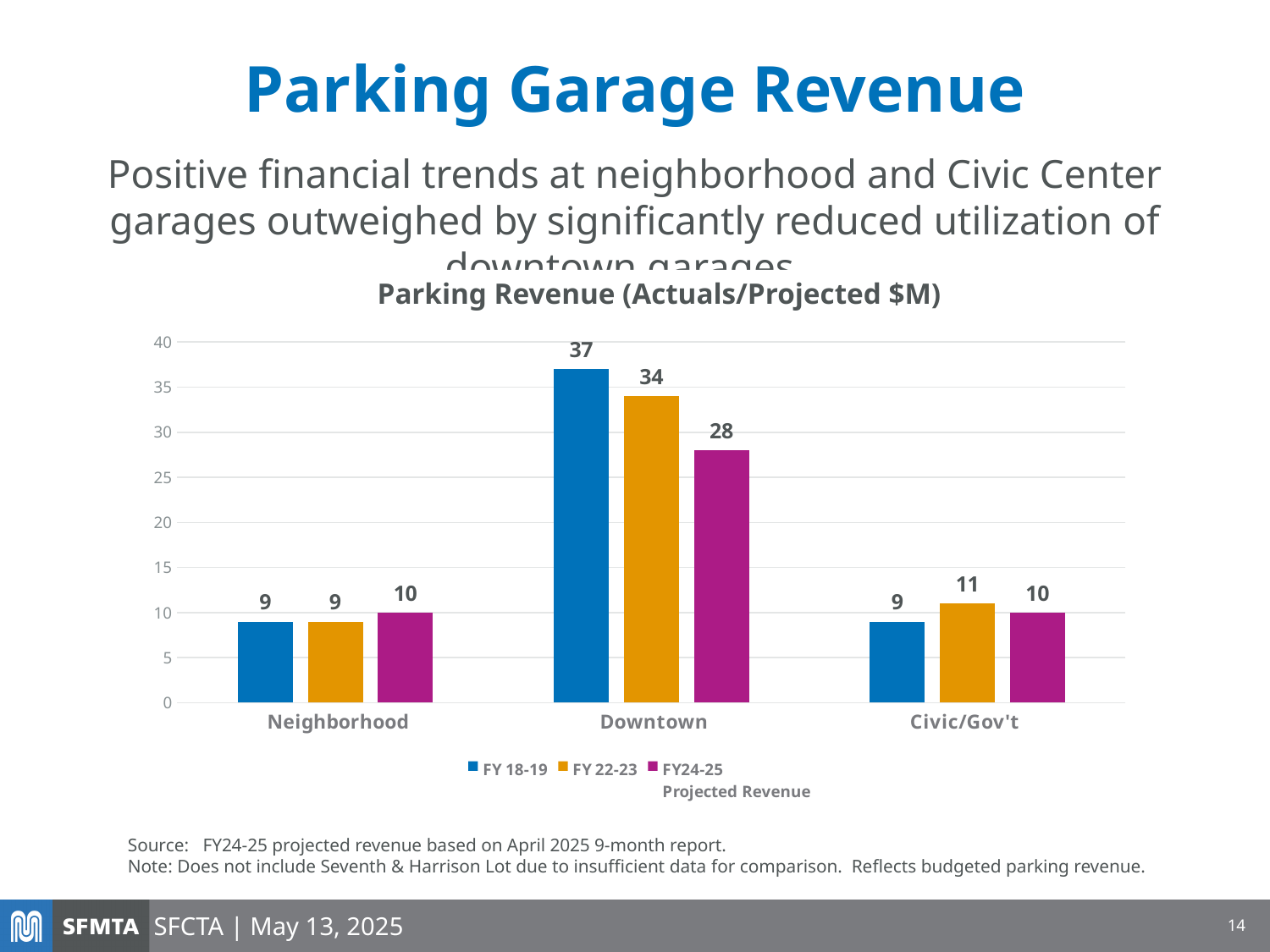
Which is larger for Civic/Gov't: the FY 22-23 value or the FY 18-19 value? FY 22-23 How many series does the legend list? 3 What is the FY 22-23 value for Neighborhood? 9 What is the FY24-25 value for Civic/Gov't? 10 What is the difference between the FY 18-19 and FY24-25 values for Downtown? 9 How many categories are shown on the x axis? 3 What is the FY 18-19 value for Downtown? 37 Is the FY 22-23 value for Downtown greater or less than 30? greater Which category has the highest FY 22-23 value? Downtown What kind of chart is shown? bar chart Which category has the lowest FY24-25 value? Neighborhood and Civic/Gov't (both 10) What is the title of the chart? Parking Revenue (Actuals/Projected $M)